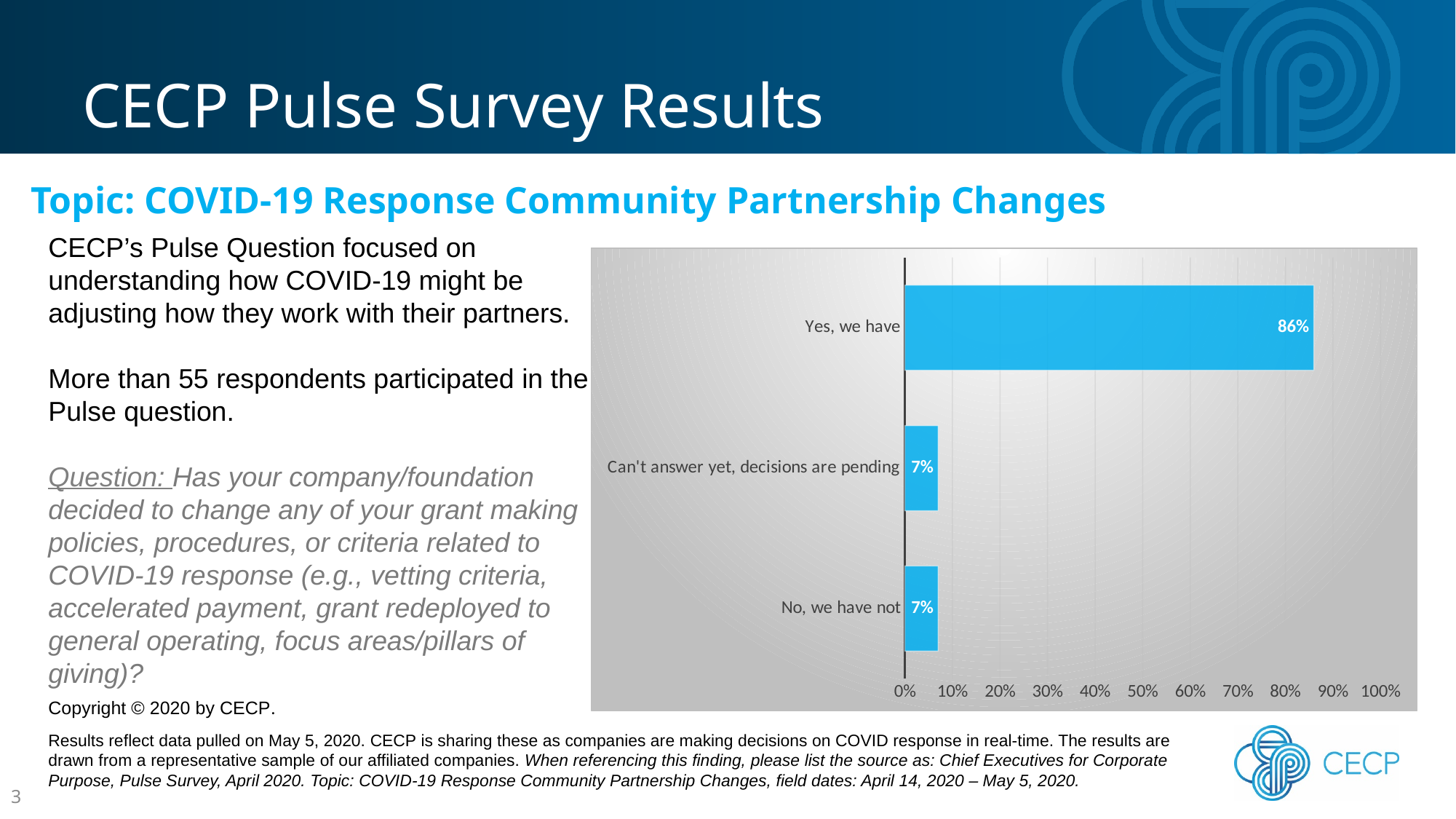
What percentage of respondents answered "Can't answer yet, decisions are pending"? 7% What is the difference between the "Yes, we have" value and the "No, we have not" value? 79 percentage points Which is larger: the value for "Yes, we have" or the value for "Can't answer yet, decisions are pending"? Yes, we have Is the value for "No, we have not" greater or less than 10%? less Which response category has the highest value? Yes, we have What is the total of the "Can't answer yet, decisions are pending" and "No, we have not" values? 14% What kind of chart is shown on the slide? Bar chart How many response categories are shown in the chart? 3 Is the value for "Yes, we have" greater or less than 80%? greater What percentage of respondents answered "No, we have not"? 7% What percentage of respondents answered "Yes, we have"? 86% What is the maximum value shown on the chart's horizontal axis? 100%